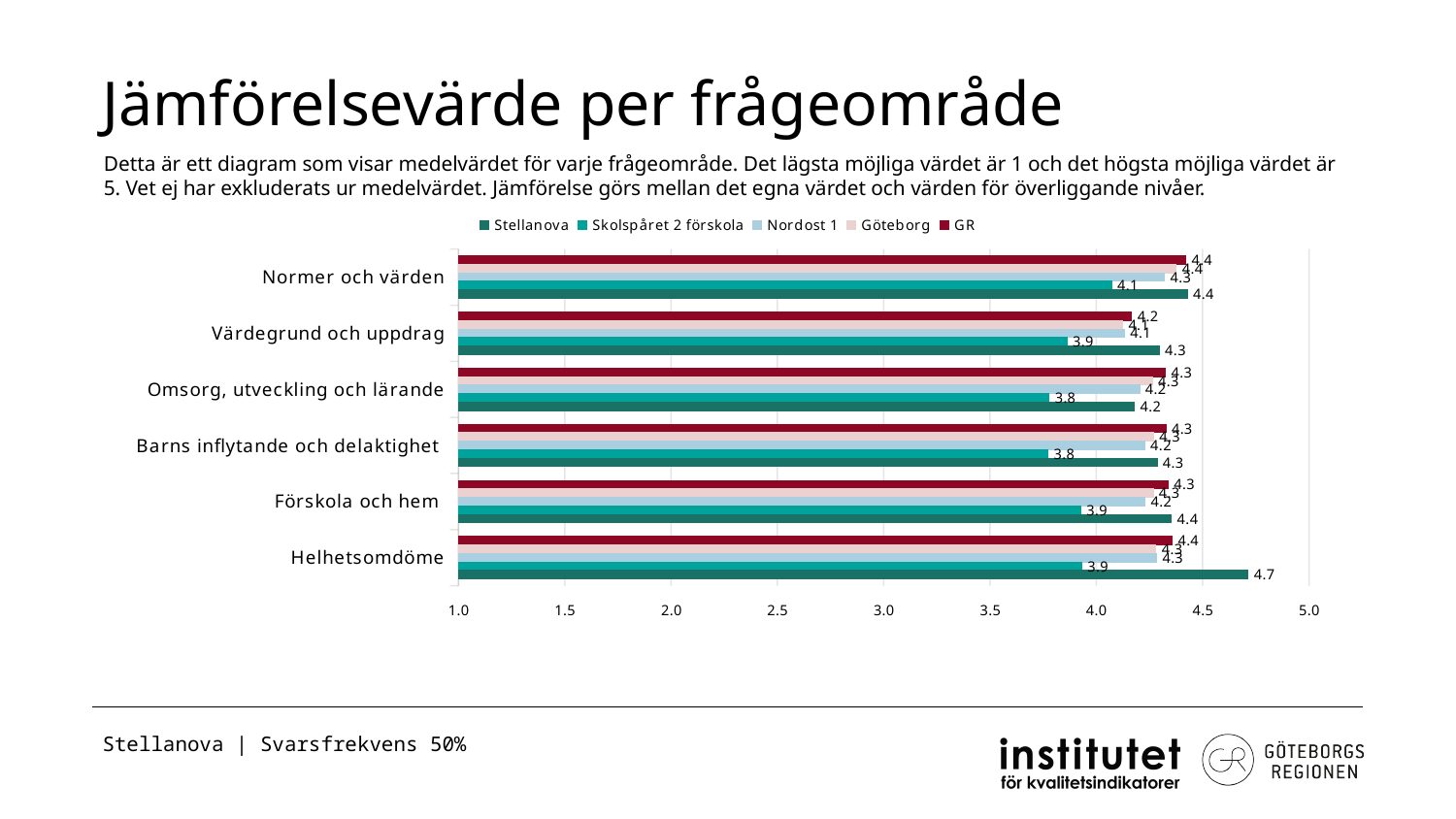
What is the value for Skolspåret 2 förskola in the Normer och värden category? 4.1 Is the value for Skolspåret 2 förskola in Barns inflytande och delaktighet greater or less than 4.0? less For Omsorg, utveckling och lärande, which is larger: the Stellanova value or the Skolspåret 2 förskola value? Stellanova What is the difference between the Stellanova and Skolspåret 2 förskola values for Helhetsomdöme? 0.8 What is the value for Stellanova in the Helhetsomdöme category? 4.7 In which category does Stellanova have its highest value? Helhetsomdöme How many question areas (categories) are shown on the chart? 6 What is the value for Stellanova in the Värdegrund och uppdrag category? 4.3 What kind of chart is shown on the slide? Bar chart How many series does the legend list? 5 What is the title of the slide? Jämförelsevärde per frågeområde What is the value for Skolspåret 2 förskola in the Omsorg, utveckling och lärande category? 3.8